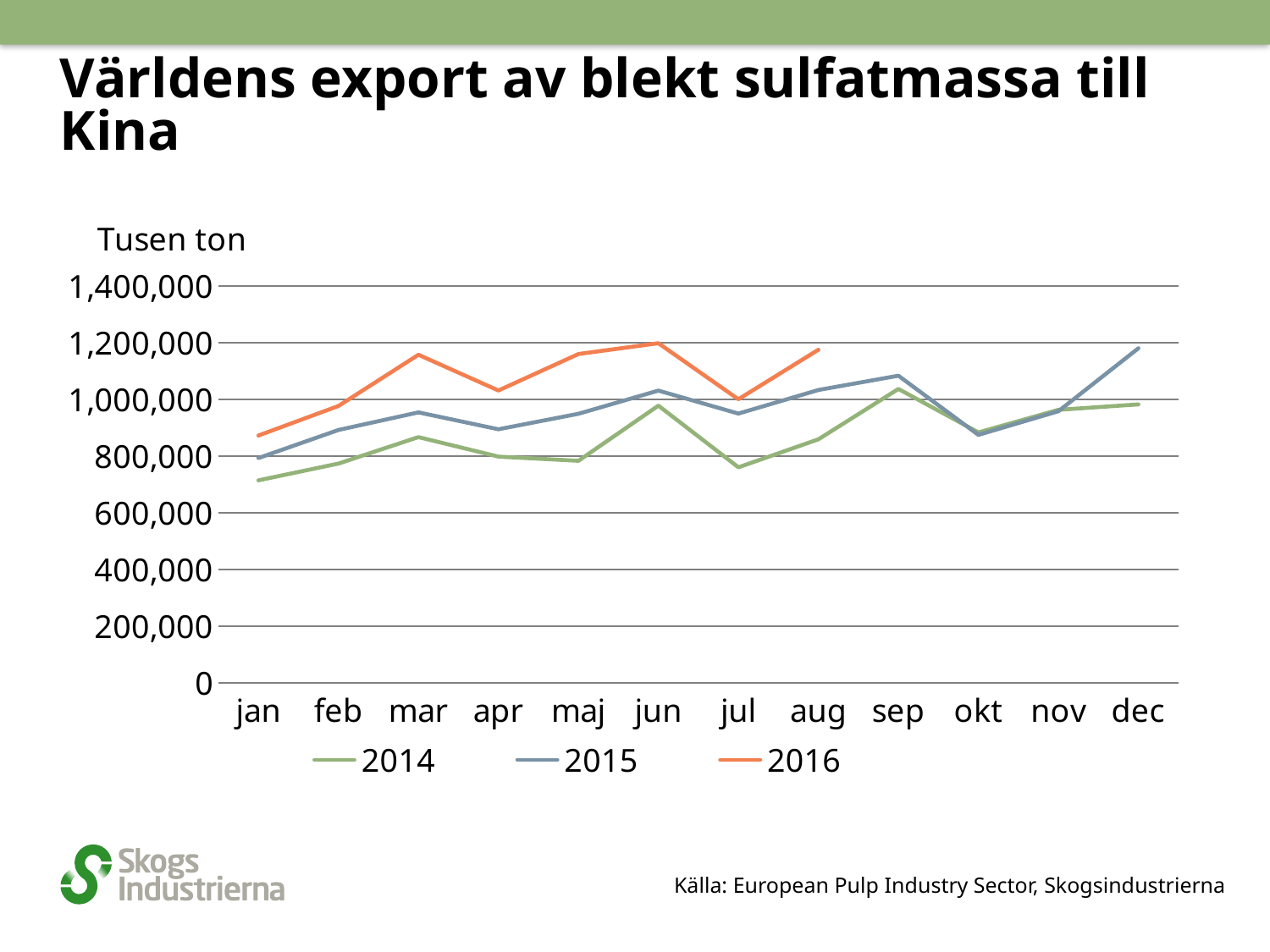
How many series does the legend list? 3 What kind of chart is shown on the slide? line chart Which is larger in jan: the value for 2014 or the value for 2016? 2016 Is the value for 2014 in jul greater or less than 800,000? less In which month does the 2015 series have its lowest value? jan Is the value for 2015 in dec greater or less than 1,000,000? greater What unit is given above the y axis? Tusen ton Is the value for 2016 in mar greater or less than 1,000,000? greater Does the 2016 series rise or fall from jan to mar? rise How many months are shown along the x axis? 12 In which month does the 2015 series reach its highest value? dec